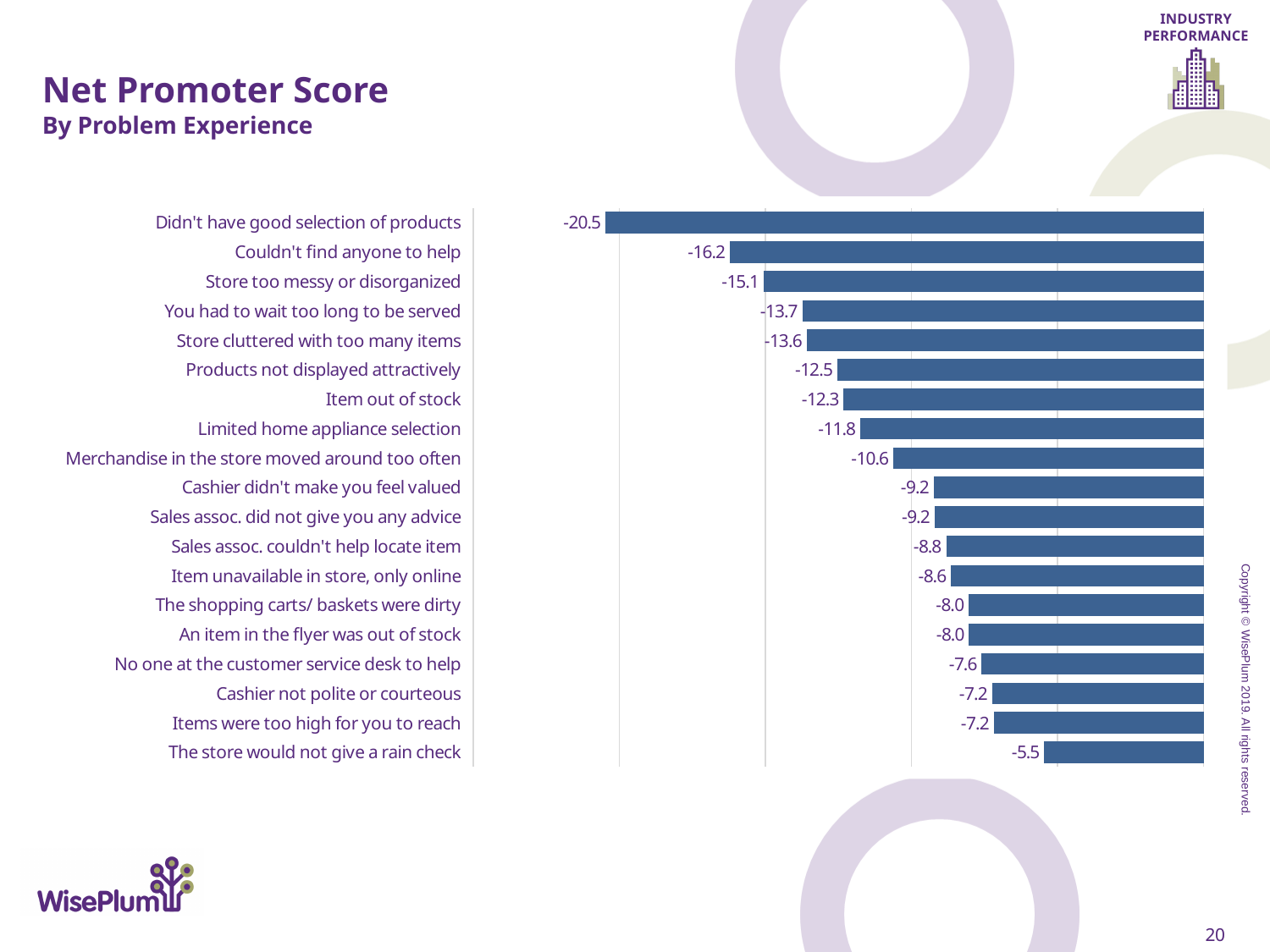
What is the Net Promoter Score for 'Item out of stock'? -12.3 How many problem experiences are shown in the chart? 19 What is the title of the chart on this slide? Net Promoter Score By Problem Experience What is the Net Promoter Score for 'Merchandise in the store moved around too often'? -10.6 What is the Net Promoter Score for 'The store would not give a rain check'? -5.5 Which problem experience has the least negative (highest) Net Promoter Score? The store would not give a rain check Which problem experience has the most negative Net Promoter Score? Didn't have good selection of products What is the difference between the Net Promoter Score for 'Couldn't find anyone to help' and 'Store too messy or disorganized'? 1.1 Which has a more negative Net Promoter Score: 'You had to wait too long to be served' or 'Products not displayed attractively'? You had to wait too long to be served What type of chart is used on this slide? Bar chart What is the difference between the Net Promoter Score for 'Didn't have good selection of products' and 'The store would not give a rain check'? 15.0 What is the Net Promoter Score for 'Didn't have good selection of products'? -20.5